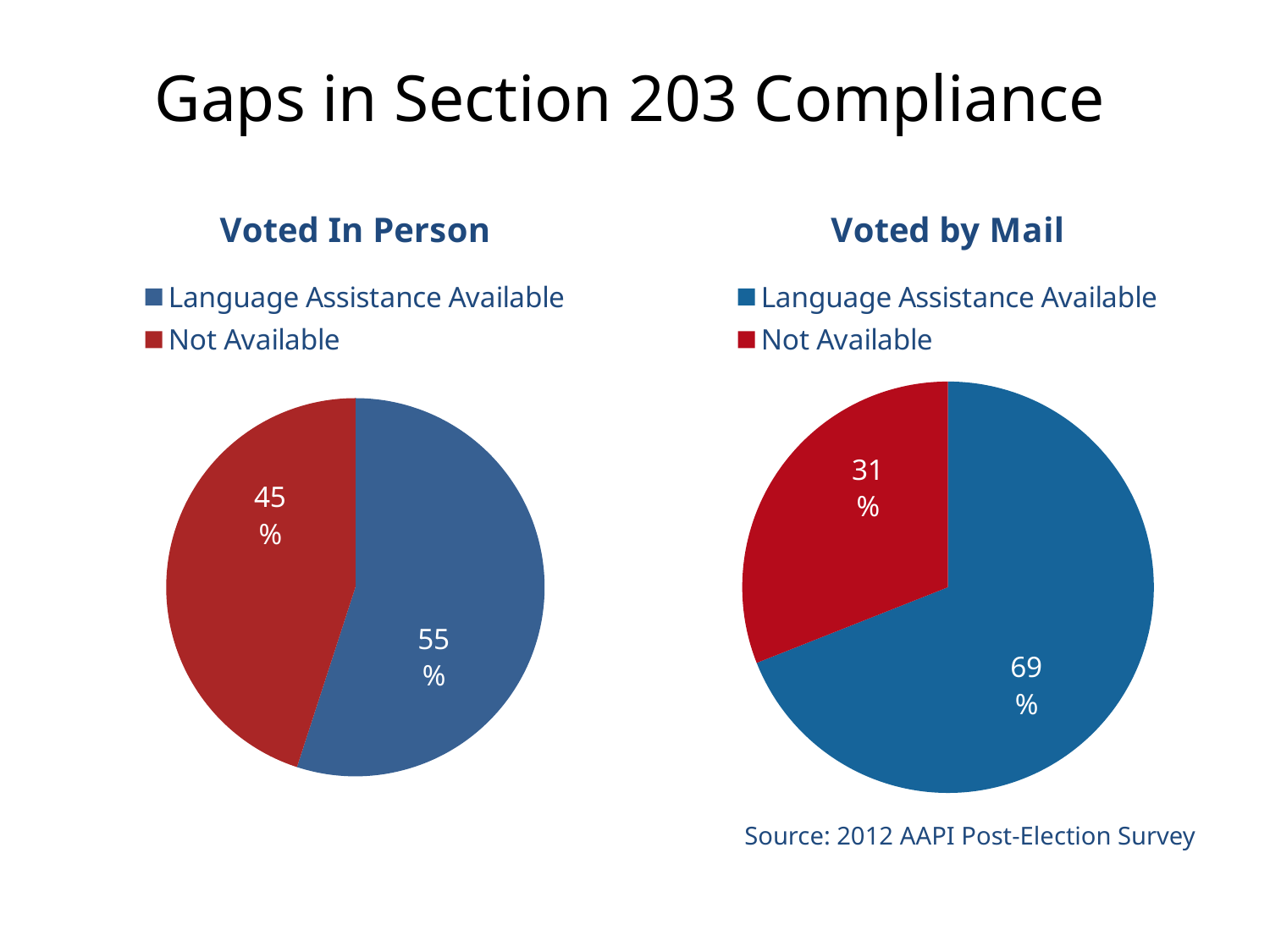
Which chart shows a larger share for Language Assistance Available, 'Voted In Person' or 'Voted by Mail'? Voted by Mail In the 'Voted In Person' chart, which slice is the smallest? Not Available In the 'Voted In Person' chart, what is the difference between the Language Assistance Available and Not Available slices? 10% In the 'Voted by Mail' chart, what percentage is shown for Language Assistance Available? 69% In the 'Voted by Mail' chart, what percentage is shown for Not Available? 31% In the 'Voted In Person' chart, what percentage is shown for Language Assistance Available? 55% In the 'Voted by Mail' chart, which slice is the largest? Language Assistance Available In the 'Voted In Person' chart, what percentage is shown for Not Available? 45% In the 'Voted by Mail' chart, what is the difference between the Language Assistance Available and Not Available slices? 38% What colour is the Not Available slice in the 'Voted by Mail' chart? Red What kind of chart is the 'Voted In Person' chart? Pie chart How many entries does the legend of the 'Voted by Mail' chart list? 2